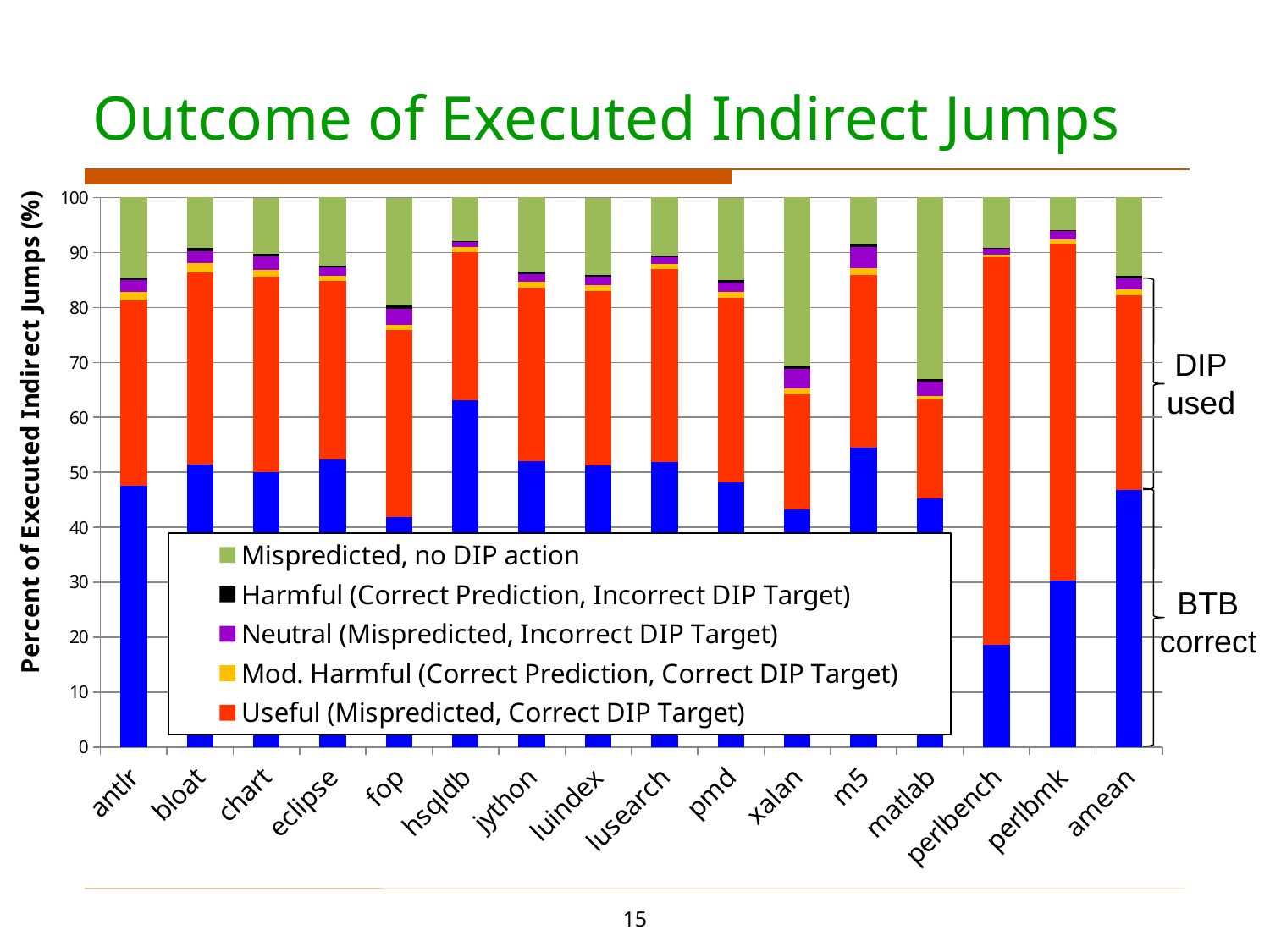
Is the 'BTB correct' (blue) value for matlab greater or less than 50? less Is the 'BTB correct' (blue) value for antlr greater or less than 40? greater Which benchmark has the highest 'BTB correct' (blue) segment? hsqldb What kind of chart is shown on the slide? Stacked bar chart Is the 'BTB correct' (blue) value for hsqldb greater or less than 60? greater How many series does the legend list? 5 What is the label of the y axis? Percent of Executed Indirect Jumps (%) What is the total height of the stacked bar for antlr? 100 Which has a larger 'BTB correct' (blue) segment, hsqldb or perlbench? hsqldb How many categories (benchmarks) are shown along the x axis? 16 Which benchmark has the lowest 'BTB correct' (blue) segment? perlbench